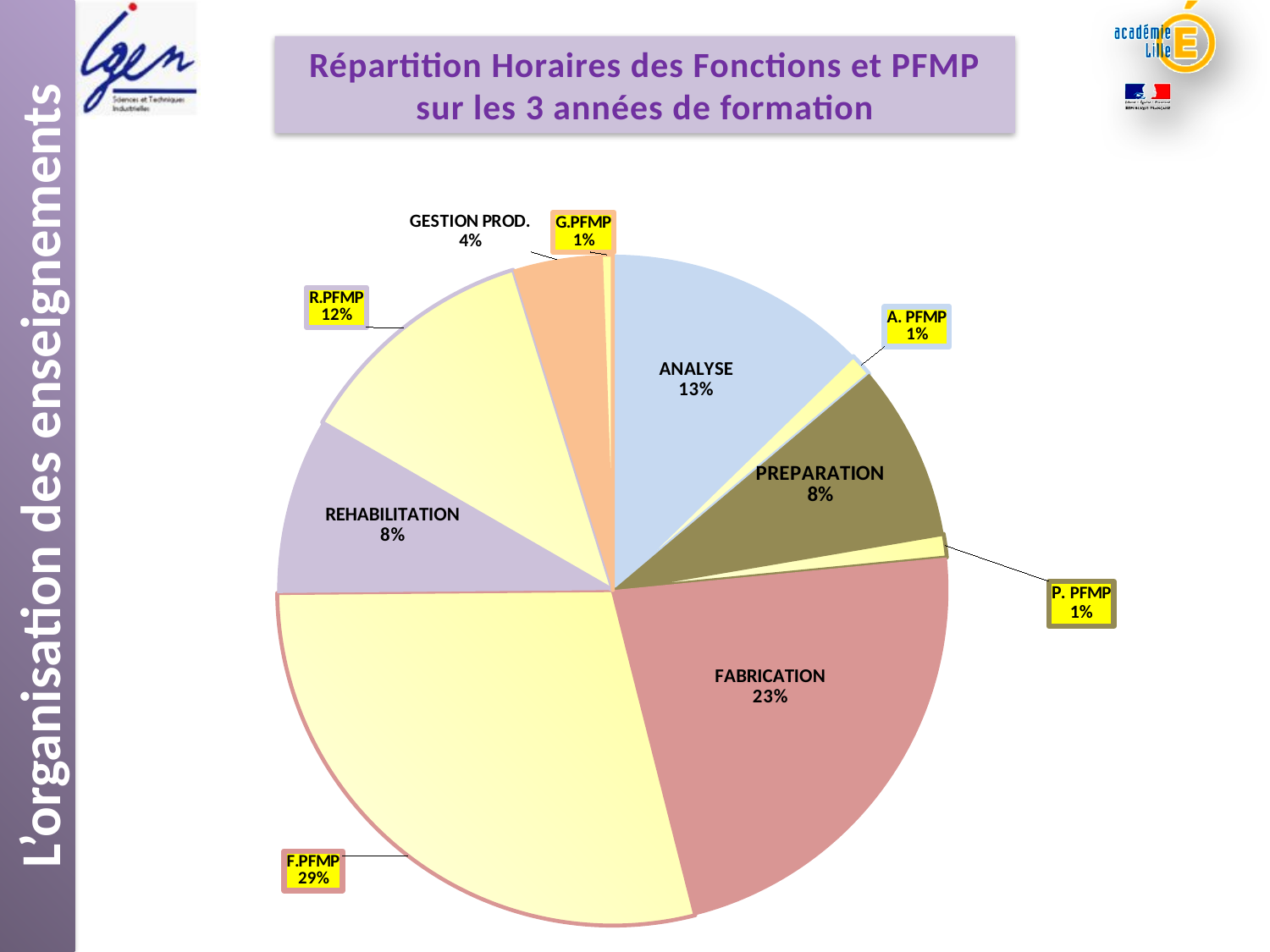
How many slices does the pie chart have? 10 What is the difference between the shares of F.PFMP and FABRICATION? 6% What is the share for GESTION PROD.? 4% What is the share for ANALYSE? 13% What is the share for R.PFMP? 12% What is the share for FABRICATION? 23% What is the share for F.PFMP? 29% What is the combined share of REHABILITATION and R.PFMP? 20% Which slice has the largest share? F.PFMP Which is larger, the share for ANALYSE or the share for PREPARATION? ANALYSE What is the title of the chart? Répartition Horaires des Fonctions et PFMP sur les 3 années de formation What type of chart is shown on the slide? pie chart